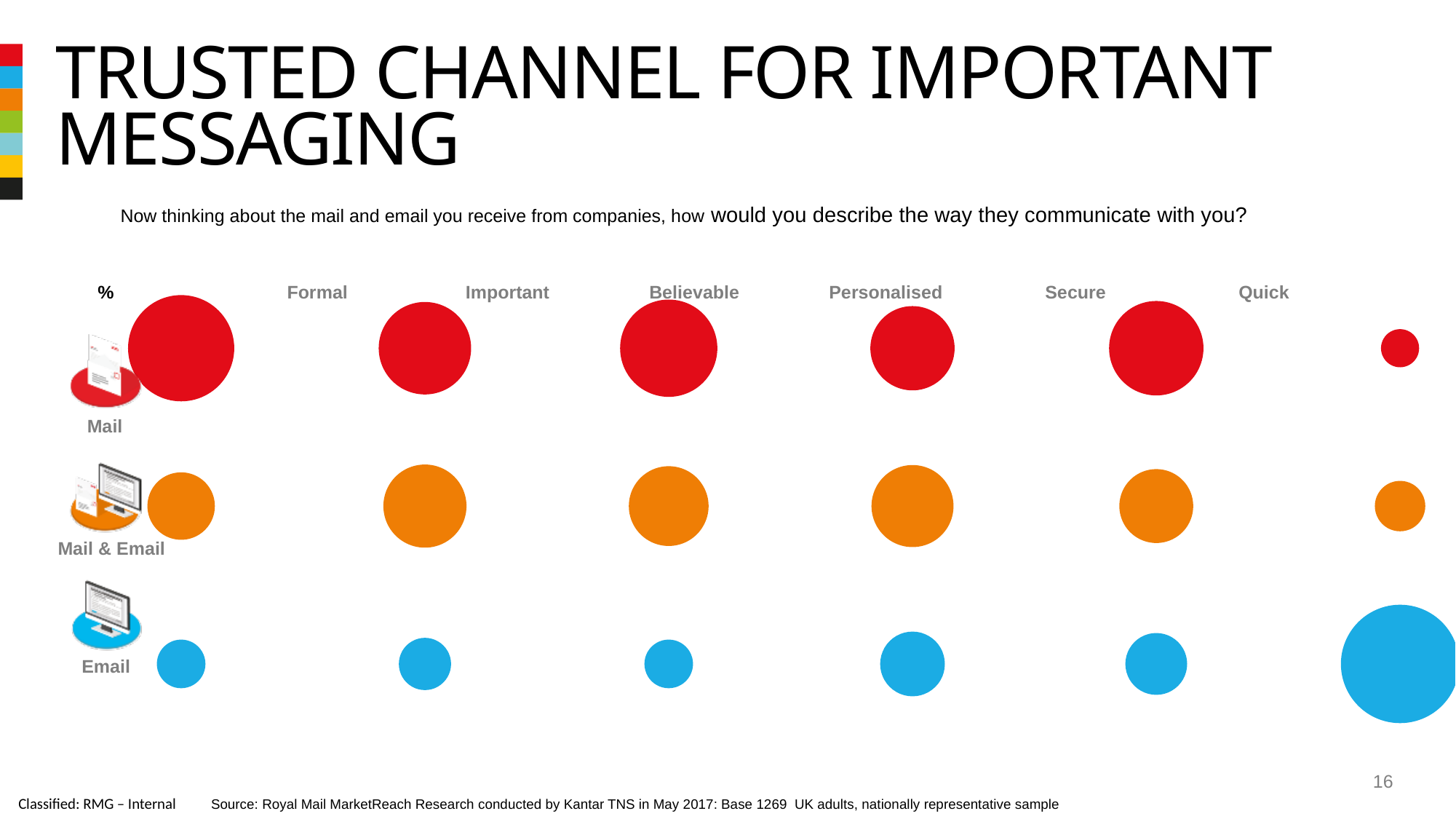
In the Mail row, which attribute has the smallest bubble? Quick For the Secure attribute, which channel has the smallest bubble? Email In the Email row, which attribute has the largest bubble? Quick How many channel rows (series) does the chart show? 3 For the Quick attribute, which channel has the smallest bubble? Mail How many attribute categories are shown along the top of the chart? 6 What kind of chart is shown on the slide? bubble chart What colour are the bubbles for the Email row? blue For the Formal attribute, which channel has the largest bubble? Mail For the Believable attribute, which is larger: the Mail bubble or the Email bubble? Mail For the Quick attribute, which channel has the largest bubble? Email